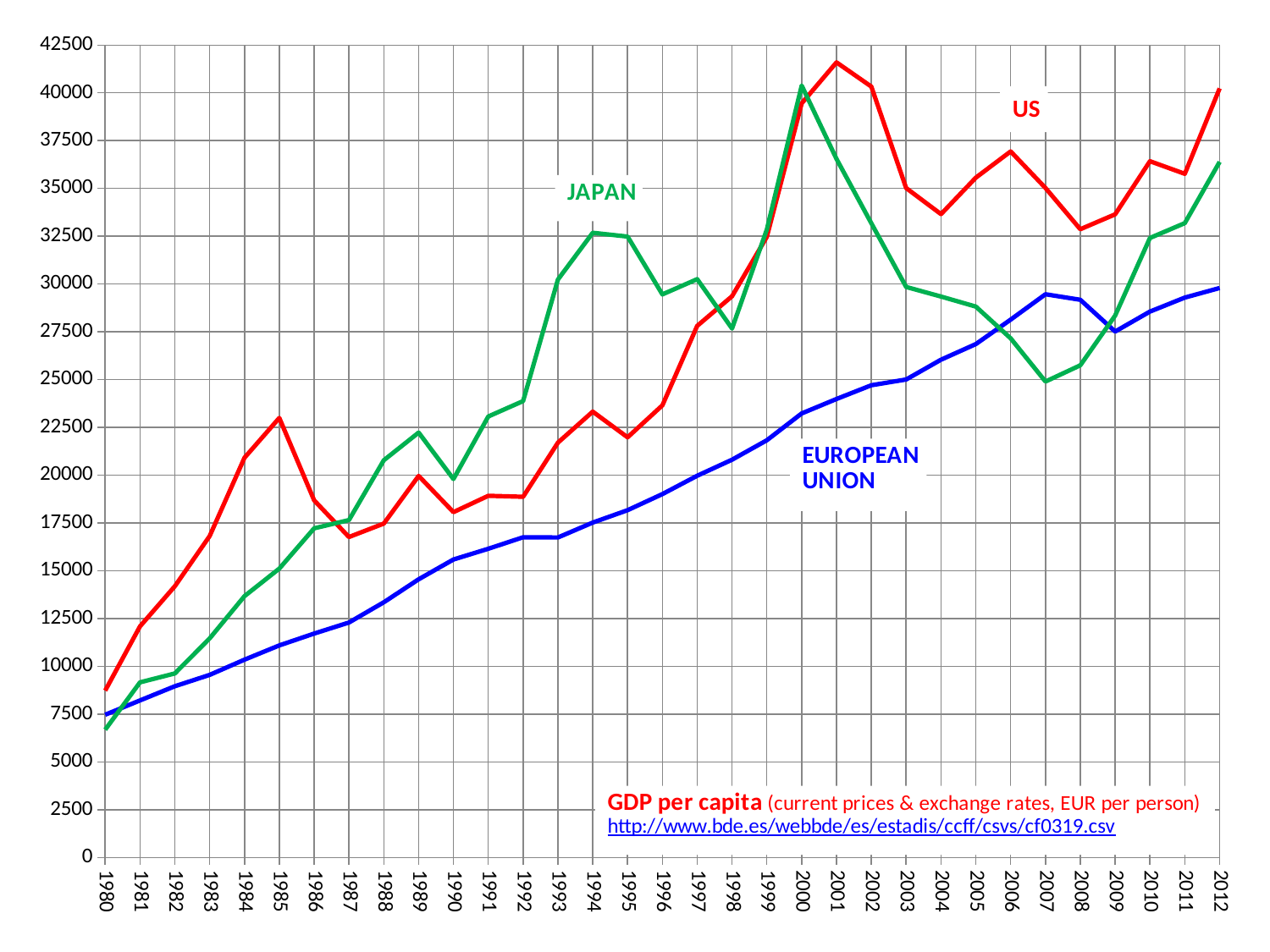
What kind of chart is shown on the slide? line chart How many series are plotted on the chart? 3 Is the value for JAPAN in 1994 greater or less than 30000? greater How many years are shown along the x axis of the chart? 33 Is the value for EUROPEAN UNION in 2012 greater or less than 27500? greater Is the value for US in 1980 greater or less than 10000? less Does the EUROPEAN UNION series generally rise or fall from 1980 to 2012? rise In 1985, which is higher, US or JAPAN? US Which series has the lowest value in 2012? EUROPEAN UNION In 2007, which is higher, EUROPEAN UNION or JAPAN? EUROPEAN UNION In which year does the US series reach its highest value? 2001